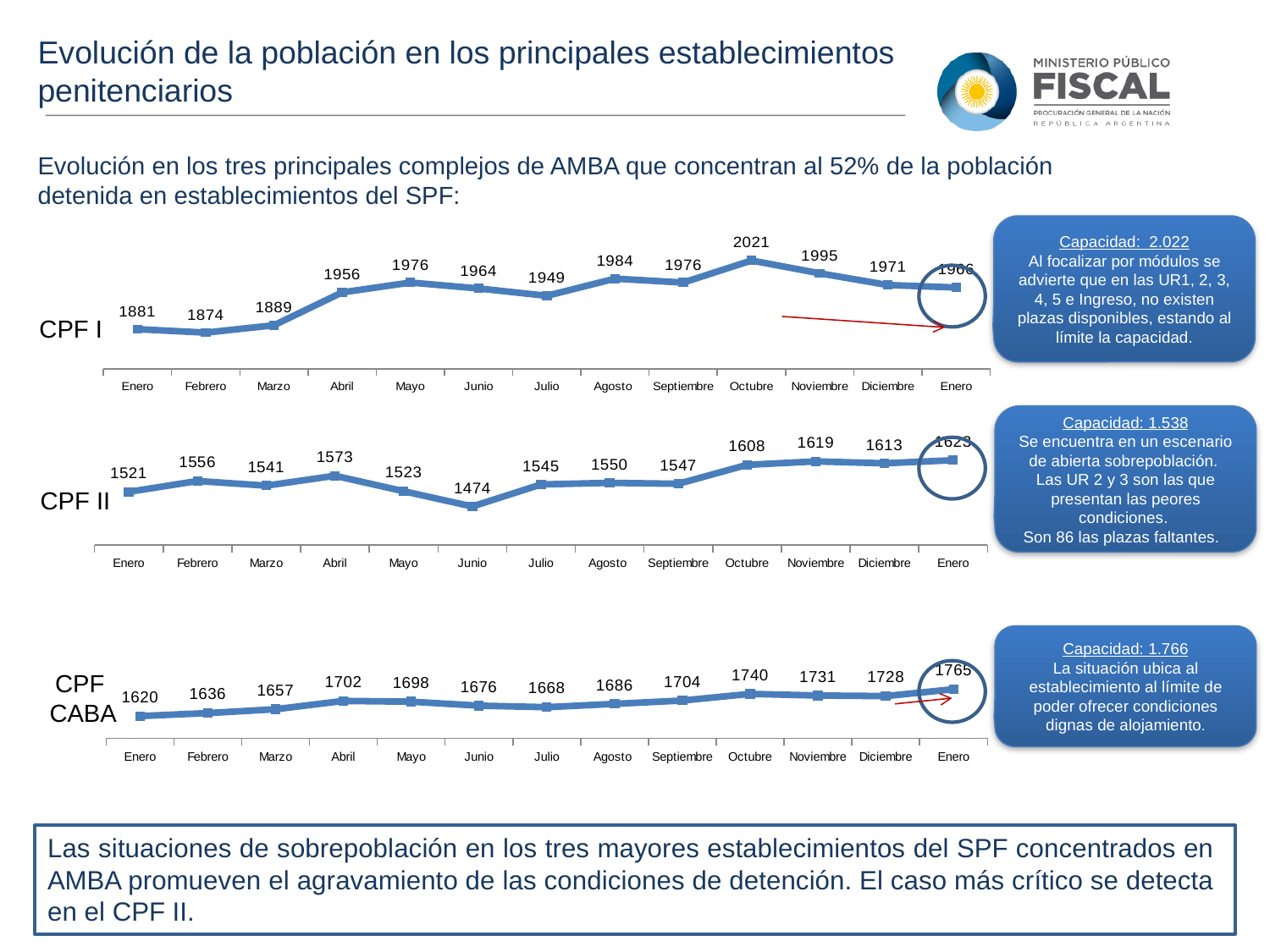
In the CPF CABA chart, what is the difference between the Octubre value and the Septiembre value? 36 In the CPF CABA chart, do the values generally rise or fall from the first Enero to the last Enero? Rise In the CPF II chart, which month has the lowest value? Junio In the CPF CABA chart, which month has the lowest value? Enero (the first one) How many data points are plotted in the CPF CABA chart? 13 In the CPF I chart, which month has the highest value? Octubre In the CPF II chart, what is the value for Junio? 1474 In the CPF CABA chart, what is the value for Abril? 1702 In the CPF I chart, what is the difference between the Octubre value and the first Enero value? 140 In the CPF II chart, which is larger, the value for Abril or the value for Mayo? Abril In the CPF I chart, what is the value for Octubre? 2021 What kind of chart is the CPF II chart? Line chart